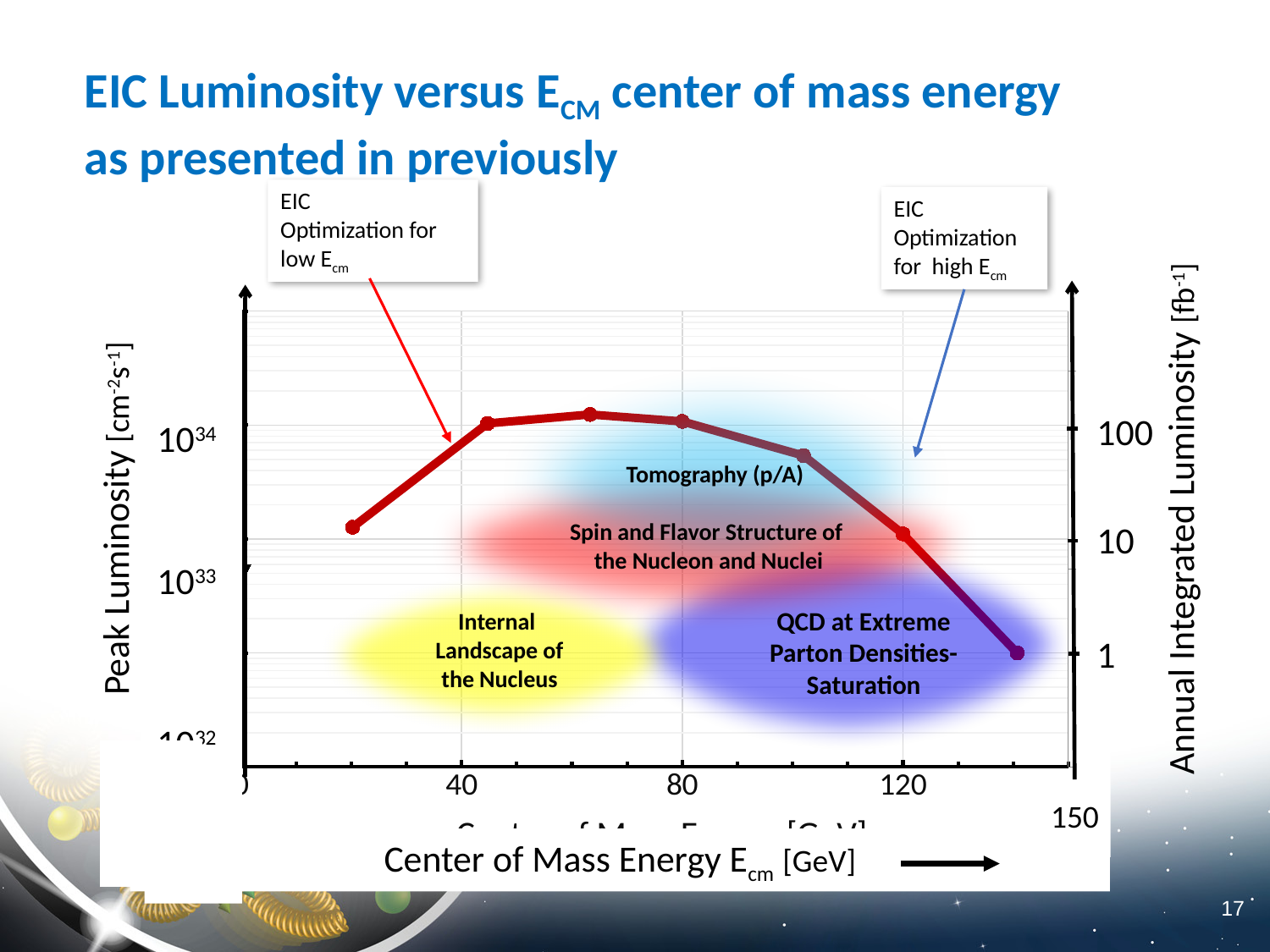
What is the label of the x axis? Center of Mass Energy Ecm [GeV] What is the label of the left y axis? Peak Luminosity [cm-2s-1] What is the highest tick value shown on the right-hand Annual Integrated Luminosity axis? 100 How many data points are plotted on the luminosity curve? 7 Is the peak luminosity at a center of mass energy of 80 GeV greater or less than 10^33 cm-2s-1? greater Is the peak luminosity at a center of mass energy of 120 GeV greater or less than 10^33 cm-2s-1? greater Is the peak luminosity at a center of mass energy of 120 GeV greater or less than 10^34 cm-2s-1? less Does the peak luminosity rise or fall as the center of mass energy increases from 80 GeV to 120 GeV? fall Which is larger, the peak luminosity at 120 GeV or at the highest plotted energy (about 140 GeV)? 120 GeV What kind of chart is shown on the slide? line chart Which is larger, the peak luminosity at 80 GeV or at 120 GeV? 80 GeV